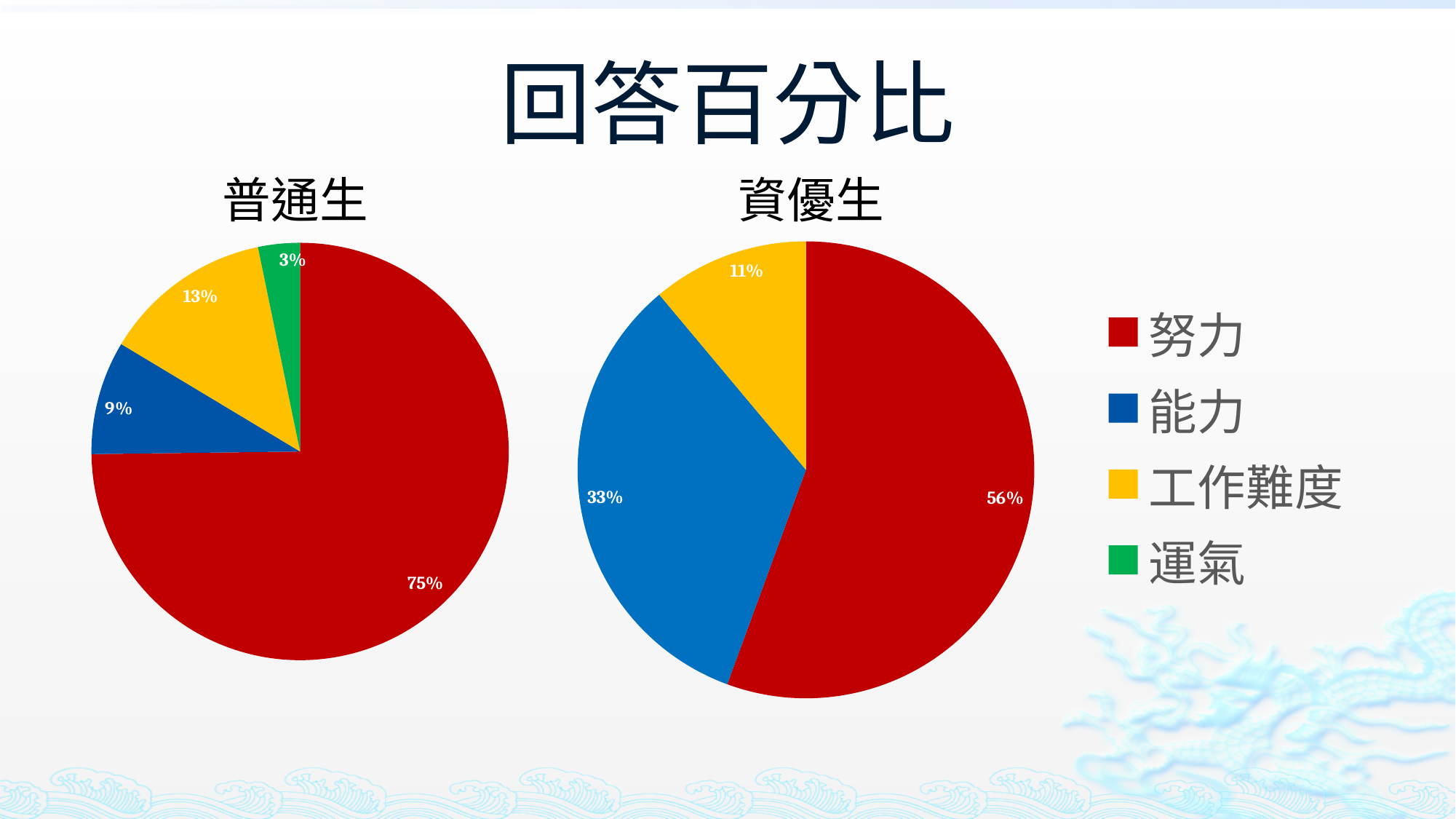
Which is larger: the 能力 share in the 普通生 chart or the 能力 share in the 資優生 chart? 資優生 How many slices are visible in the 資優生 pie chart? 3 How many entries does the legend list? 4 How many slices does the 普通生 pie chart have? 4 In the 資優生 pie chart, which category has the largest share? 努力 In the 資優生 pie chart, what percentage is shown for 工作難度? 11% What type of chart is used for 普通生 and 資優生? Pie chart In the 普通生 pie chart, what percentage is shown for 運氣? 3% In the 資優生 pie chart, what percentage is shown for 能力? 33% In the 普通生 pie chart, which category has the smallest share? 運氣 In the 普通生 pie chart, what percentage is shown for 努力? 75% What is the difference between the 努力 share in the 普通生 chart and the 努力 share in the 資優生 chart? 19%